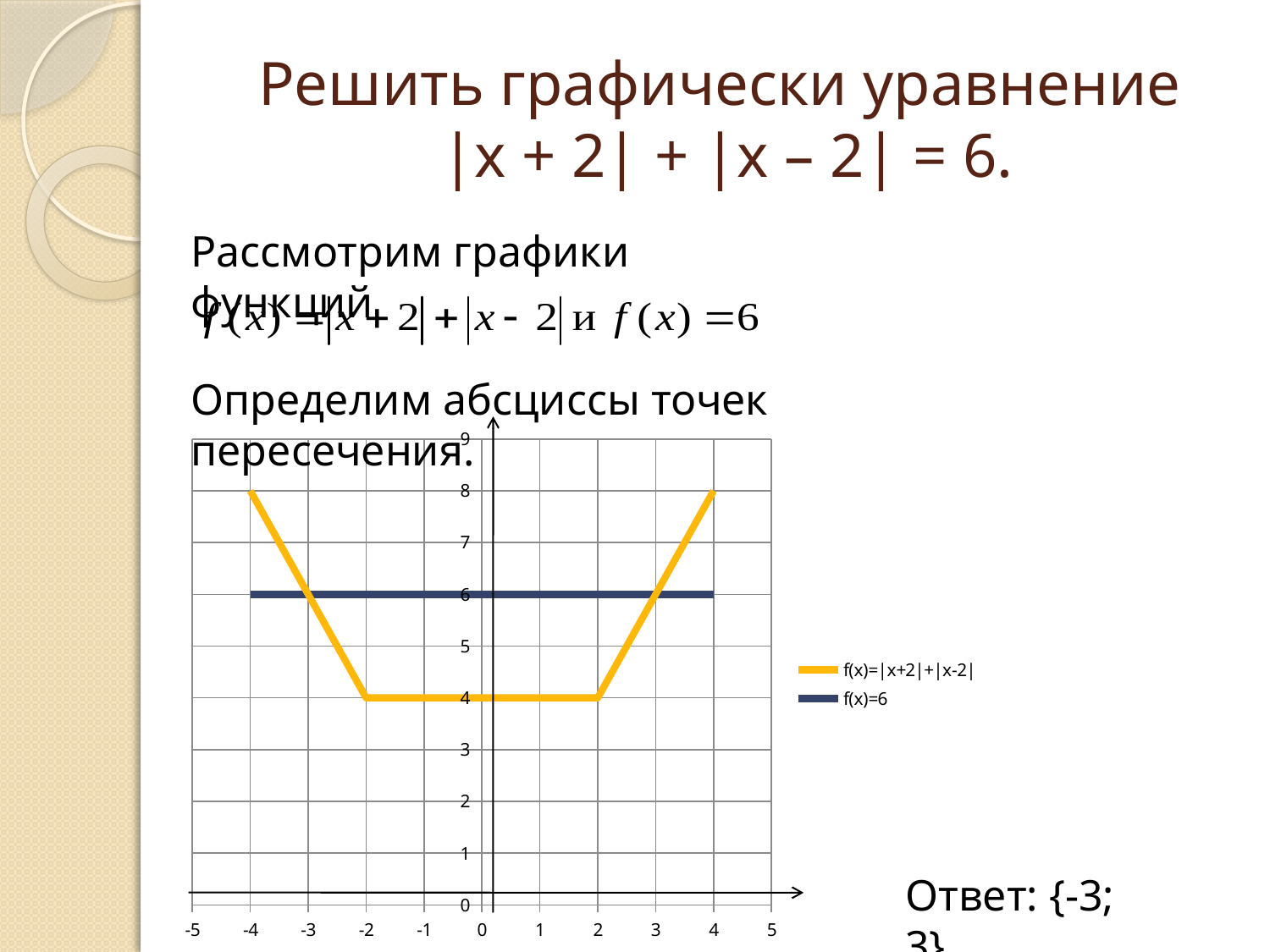
Is the value of f(x)=|x+2|+|x-2| at x = 4 greater or less than 6? greater What constant value does the series f(x)=6 take on the chart? 6 What kind of chart is shown on the slide? line chart What is the value of f(x)=|x+2|+|x-2| at x = 2? 4 What colour is the line for f(x)=6 in the chart? dark blue How many series does the chart legend list? 2 Is the value of f(x)=|x+2|+|x-2| at x = -1 greater or less than 6? less Does the series f(x)=|x+2|+|x-2| rise or fall as x goes from 2 to 4? rise Which series has the larger value at x = 0, f(x)=|x+2|+|x-2| or f(x)=6? f(x)=6 What is the value of f(x)=|x+2|+|x-2| at x = -4? 8 What is the value of f(x)=|x+2|+|x-2| at x = 0? 4 What is the value of f(x)=|x+2|+|x-2| at x = 4? 8